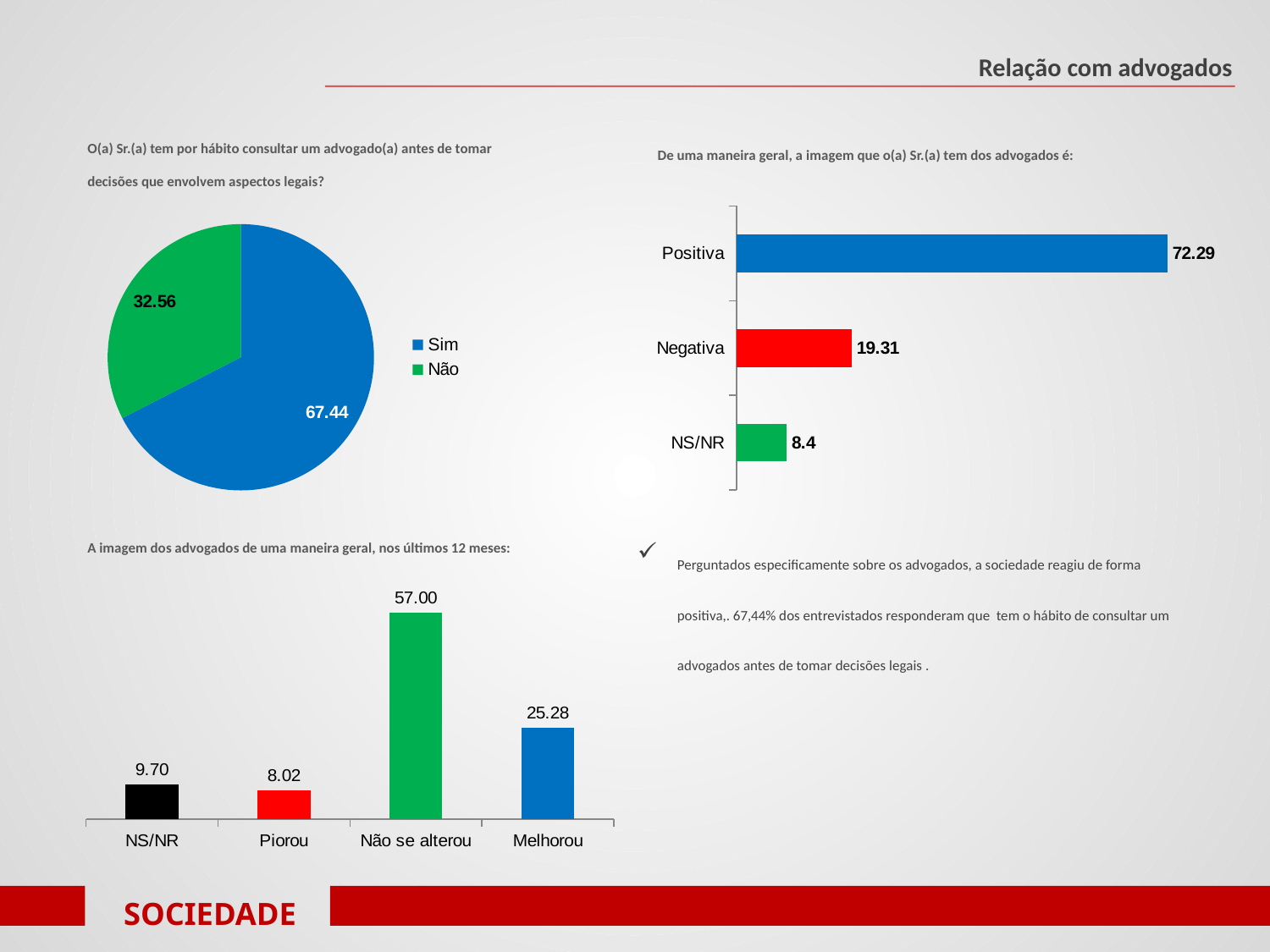
In the top-right bar chart, which category has the lowest value? NS/NR In the bottom-left bar chart, how many categories are shown? 4 In the top-left pie chart, what is the value for Sim? 67.44 In the bottom-left bar chart, which category has the highest value? Não se alterou In the bottom-left bar chart, which is larger, NS/NR or Piorou? NS/NR In the top-right bar chart, what is the value for NS/NR? 8.4 In the top-right bar chart, what is the difference between Positiva and Negativa? 52.98 In the bottom-left bar chart, what is the value for Não se alterou? 57.00 In the top-left pie chart, how many slices are there? 2 In the top-left pie chart, what is the value for Não? 32.56 In the top-right bar chart, what is the value for Positiva? 72.29 What kind of chart is the top-left chart? pie chart